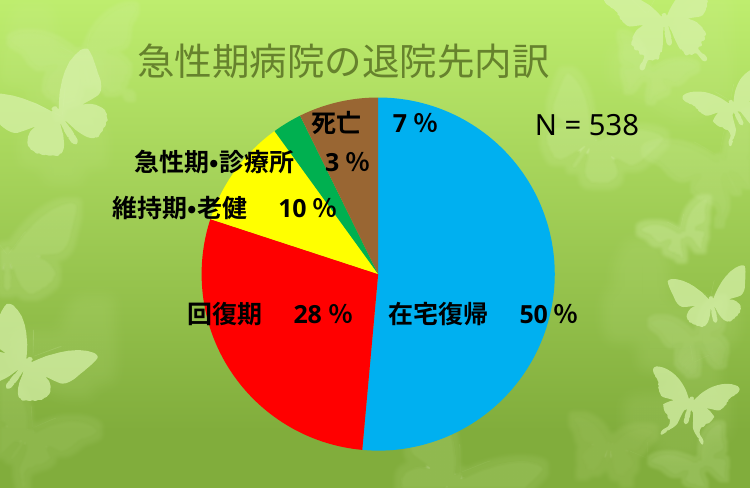
Which category has the largest share of the pie? 在宅復帰 Which category has the smallest share of the pie? 急性期・診療所 What is the share for 急性期・診療所? 3％ Which is larger, the share for 死亡 or the share for 急性期・診療所? 死亡 What is the share for 維持期・老健? 10％ What is the share for 死亡? 7％ What is the title of the chart? 急性期病院の退院先内訳 What is the difference in percentage points between 在宅復帰 and 回復期? 22 How many categories are shown in the pie chart? 5 What is the share for 回復期? 28％ What is the share for 在宅復帰? 50％ What kind of chart is shown on the slide? pie chart